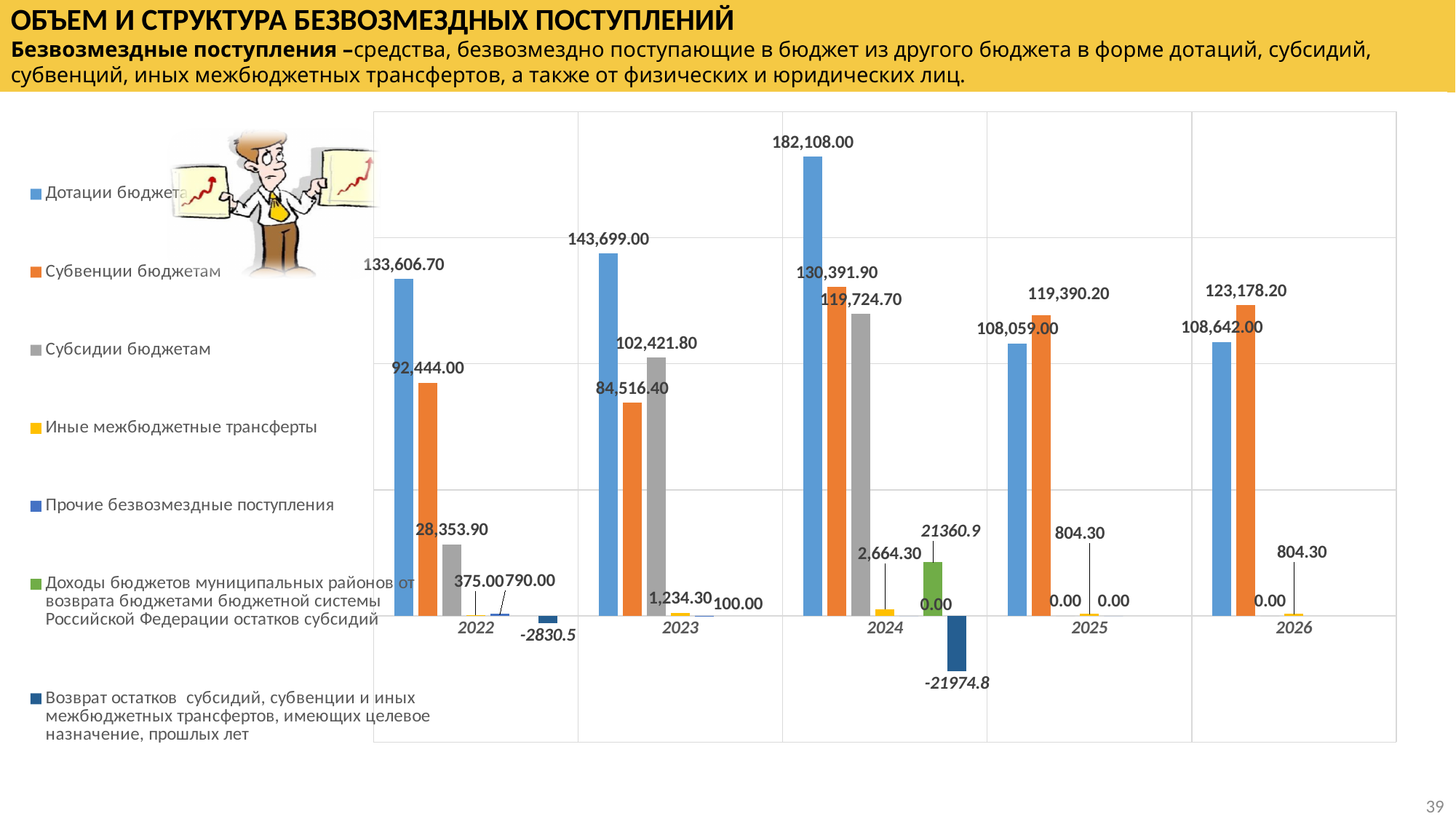
What is the value of Дотации бюджета in 2024? 182,108.00 What is the value of Субсидии бюджетам in 2023? 102,421.80 What is the difference between Дотации бюджета in 2024 and in 2023? 38,409.00 How many years are shown on the x axis? 5 What is the value of Иные межбюджетные трансферты in 2025? 804.30 Which is larger in 2026: Дотации бюджета or Субвенции бюджетам? Субвенции бюджетам In which year is Субвенции бюджетам lowest? 2023 In which year is Дотации бюджета highest? 2024 What is the value of Возврат остатков субсидий, субвенции и иных межбюджетных трансфертов in 2024? -21974.8 What is the value of Субвенции бюджетам in 2022? 92,444.00 How many series does the legend list? 7 What type of chart is shown on the slide? Bar chart